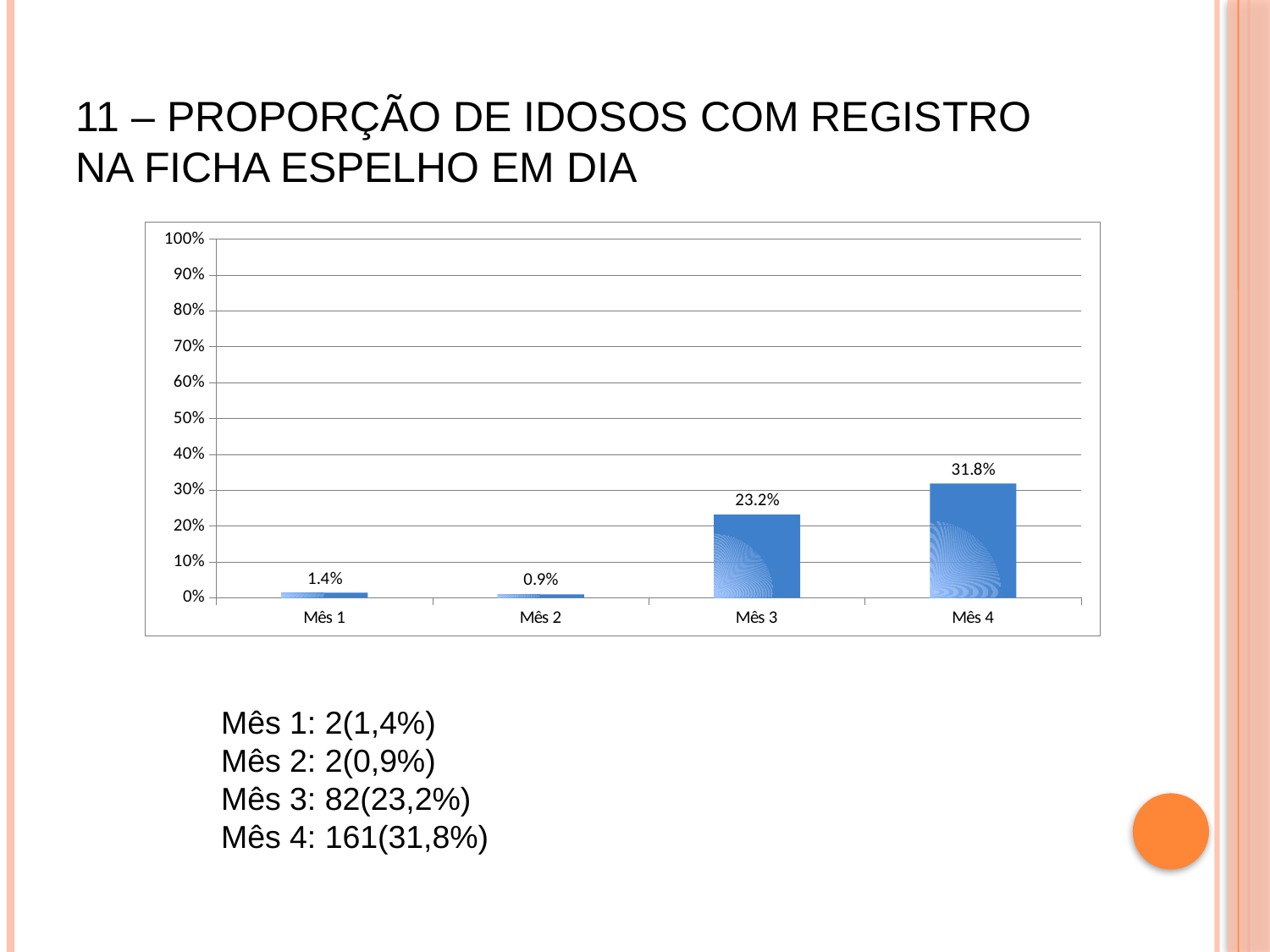
What is the value for Mês 4? 31.8% Which month has the lowest value? Mês 2 What is the value for Mês 3? 23.2% Which month has the highest value? Mês 4 What is the value for Mês 1? 1.4% How many months are shown on the x axis? 4 What is the difference between the values for Mês 4 and Mês 3? 8.6% Is the value for Mês 4 greater or less than 40%? less Do the values rise or fall from Mês 2 to Mês 4? rise What is the difference between the values for Mês 1 and Mês 2? 0.5% What kind of chart is shown on the slide? bar chart Which is larger, the value for Mês 3 or the value for Mês 4? Mês 4